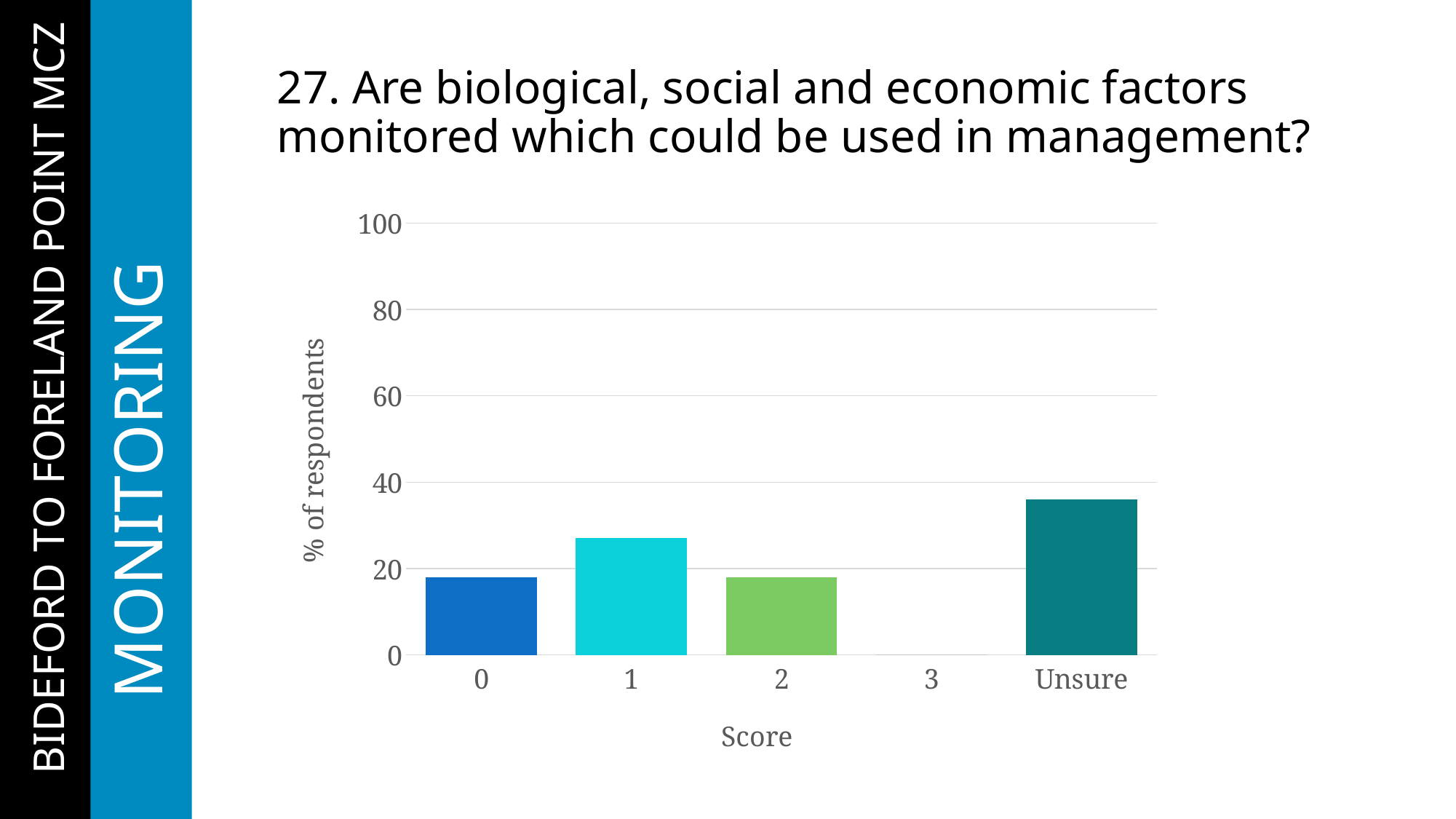
What is the value for score 3? 0 Which is larger, the value for score 1 or the value for score 0? score 1 Is the value for Unsure greater or less than 40? less Which score category has the highest percentage of respondents? Unsure Is the value for score 0 greater or less than 20? less What kind of chart is shown on the slide? bar chart Which score category has the lowest percentage of respondents? 3 Is the value for score 1 greater or less than 20? greater What is the label of the y axis? % of respondents Which is larger, the value for Unsure or the value for score 2? Unsure How many score categories are shown on the x axis? 5